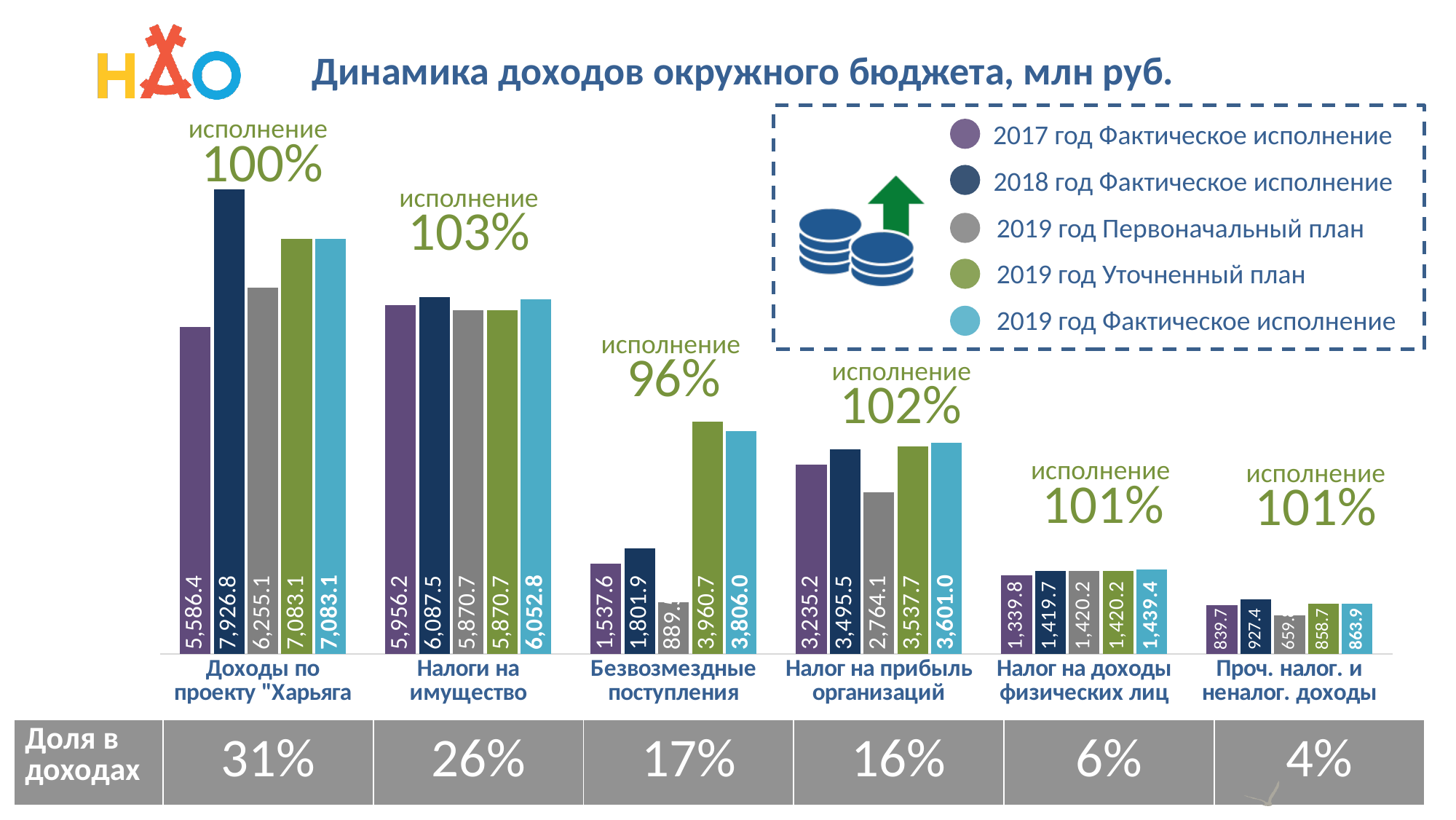
What is the 2019 год Фактическое исполнение value for Налоги на имущество? 6,052.8 How many series does the legend list? 5 Which is larger for Налог на прибыль организаций: the 2019 год Уточненный план value or the 2019 год Фактическое исполнение value? 2019 год Фактическое исполнение What is the difference between the 2018 год Фактическое исполнение and 2017 год Фактическое исполнение values for Доходы по проекту "Харьяга"? 2,340.4 How many categories are shown on the x axis of the chart? 6 Which category has the highest 2018 год Фактическое исполнение value? Доходы по проекту "Харьяга" What kind of chart is shown on the slide? Bar chart What is the 2017 год Фактическое исполнение value for Налог на прибыль организаций? 3,235.2 Which category has the lowest 2019 год Фактическое исполнение value? Проч. налог. и неналог. доходы What is the 2018 год Фактическое исполнение value for Доходы по проекту "Харьяга"? 7,926.8 What is the title of the chart? Динамика доходов окружного бюджета, млн руб. What is the 2019 год Уточненный план value for Безвозмездные поступления? 3,960.7